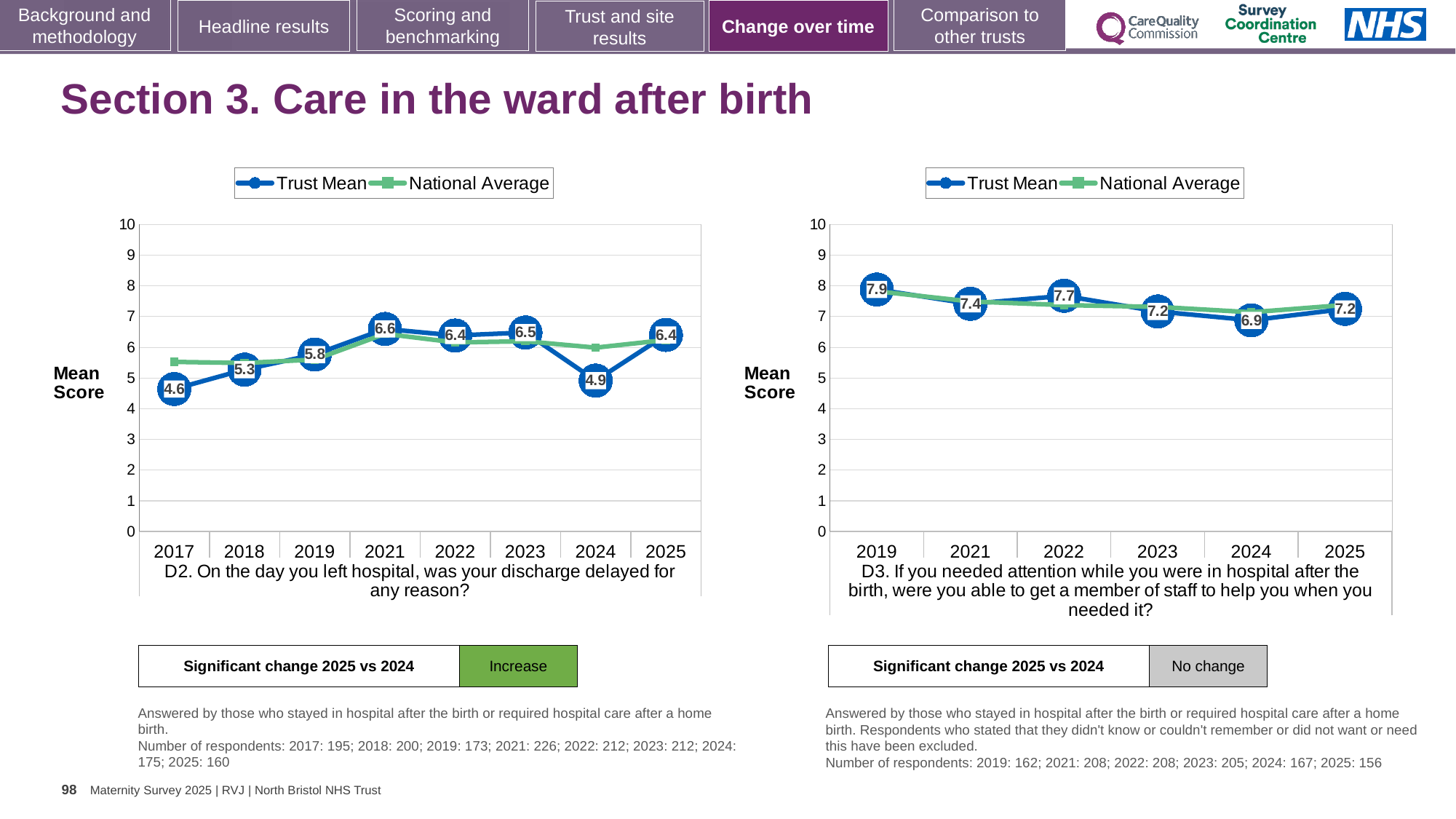
In the D2 chart (left), what is the Trust Mean score for 2017? 4.6 In the D3 chart (right), what is the Trust Mean score for 2019? 7.9 In the D3 chart (right), which year has the lowest Trust Mean score? 2024 In the D2 chart (left), what is the Trust Mean score for 2024? 4.9 What type of chart is the D2 chart (left)? Line chart In the D2 chart (left), which year has the highest Trust Mean score? 2021 How many series does the legend of the D3 chart (right) list? 2 In the D2 chart (left), which year has the lowest Trust Mean score? 2017 In the D2 chart (left), how many years are shown on the x axis? 8 In the D3 chart (right), is the National Average for 2019 greater or less than 7? greater In the D3 chart (right), is the Trust Mean score for 2022 or 2023 higher? 2022 In the D2 chart (left), what is the difference between the Trust Mean scores for 2025 and 2024? 1.5